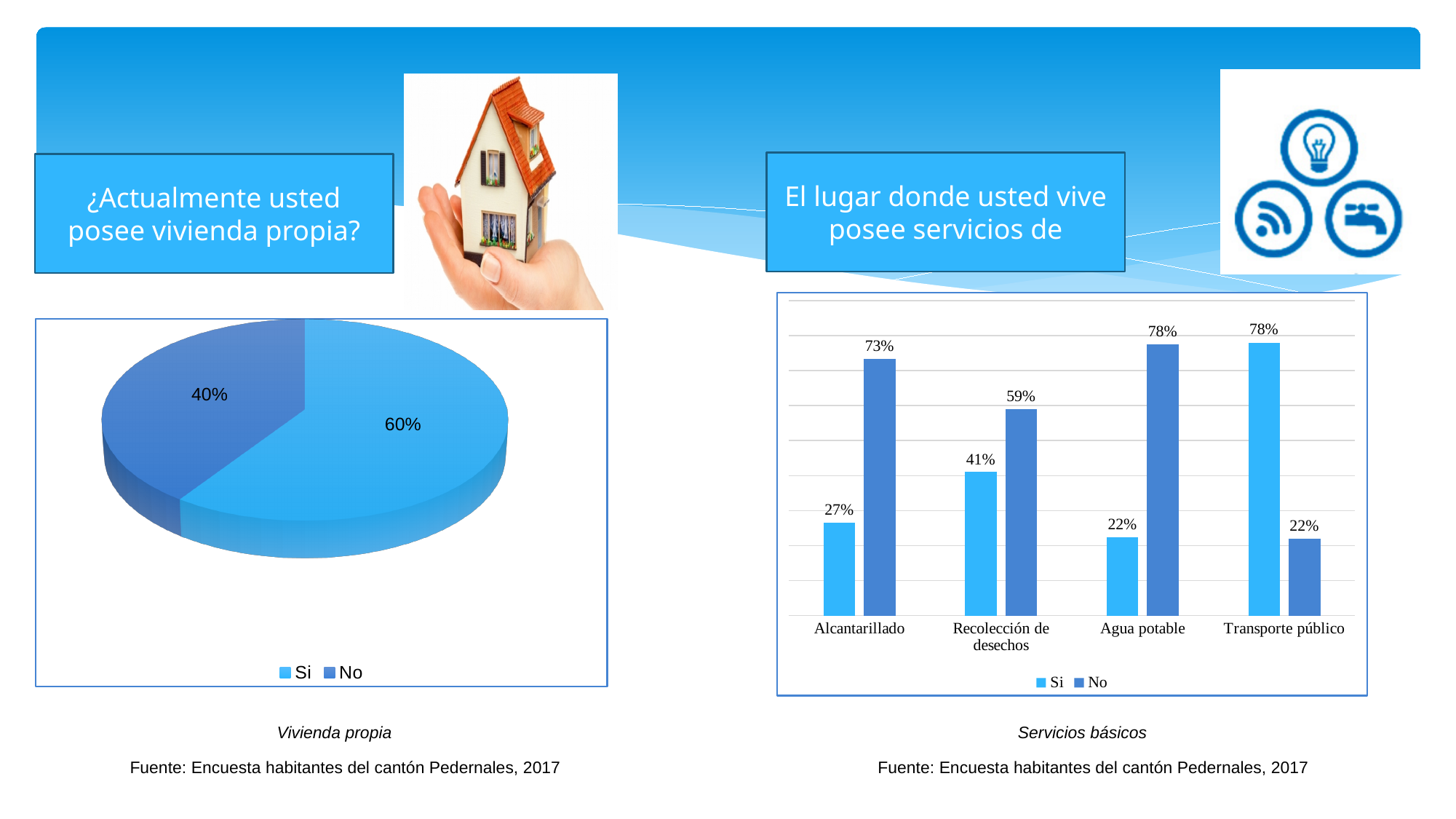
In the bar chart on the right (Servicios básicos), which category has the lowest 'No' value? Transporte público In the bar chart on the right (Servicios básicos), what is the 'No' value for Alcantarillado? 73% In the pie chart on the left (Vivienda propia), what share is labelled 'No'? 40% In the bar chart on the right (Servicios básicos), which category has the highest 'Si' value? Transporte público In the pie chart on the left (Vivienda propia), what share is labelled 'Si'? 60% In the bar chart on the right (Servicios básicos), how many categories are shown on the x axis? 4 In the bar chart on the right (Servicios básicos), what is the 'Si' value for Recolección de desechos? 41% In the bar chart on the right (Servicios básicos), what is the 'Si' value for Agua potable? 22% How many series does the legend of the left chart (Vivienda propia) list? 2 In the bar chart on the right (Servicios básicos), what is the difference between the 'No' and 'Si' values for Recolección de desechos? 18% What kind of chart is the chart on the right (Servicios básicos)? Bar chart What kind of chart is the chart on the left (Vivienda propia)? Pie chart